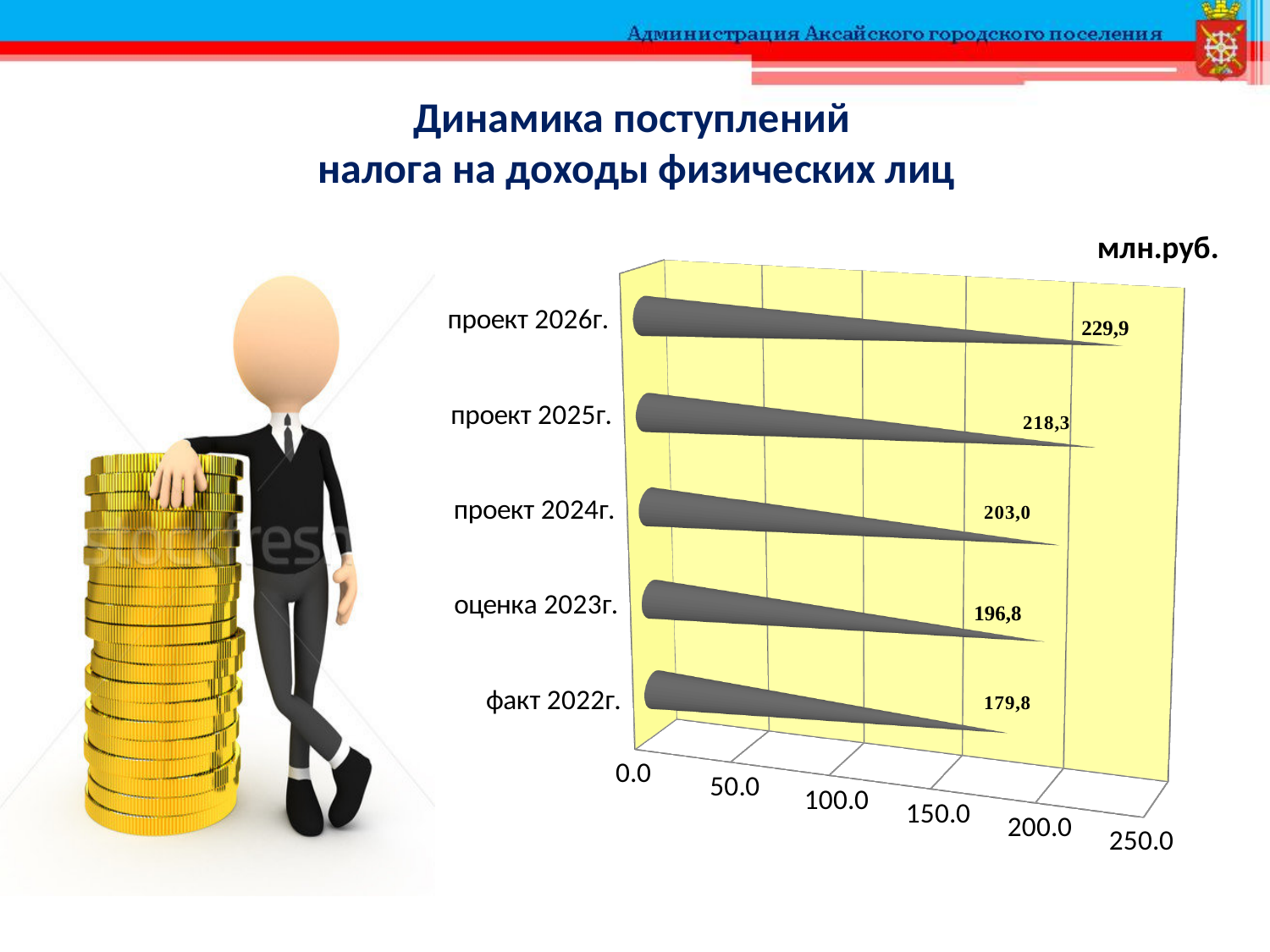
Which is larger, the value for проект 2024г. or the value for оценка 2023г.? проект 2024г. How many categories are shown in the chart? 5 Which category has the highest value? проект 2026г. What is the difference between the values for проект 2026г. and факт 2022г.? 50,1 What is the difference between the values for проект 2025г. and проект 2024г.? 15,3 Is the value for факт 2022г. greater or less than 150.0? greater Which category has the lowest value? факт 2022г. What kind of chart is shown on the slide? bar chart Do the values rise or fall from факт 2022г. to проект 2026г.? rise What is the value for проект 2026г.? 229,9 What is the value for оценка 2023г.? 196,8 What is the value for факт 2022г.? 179,8